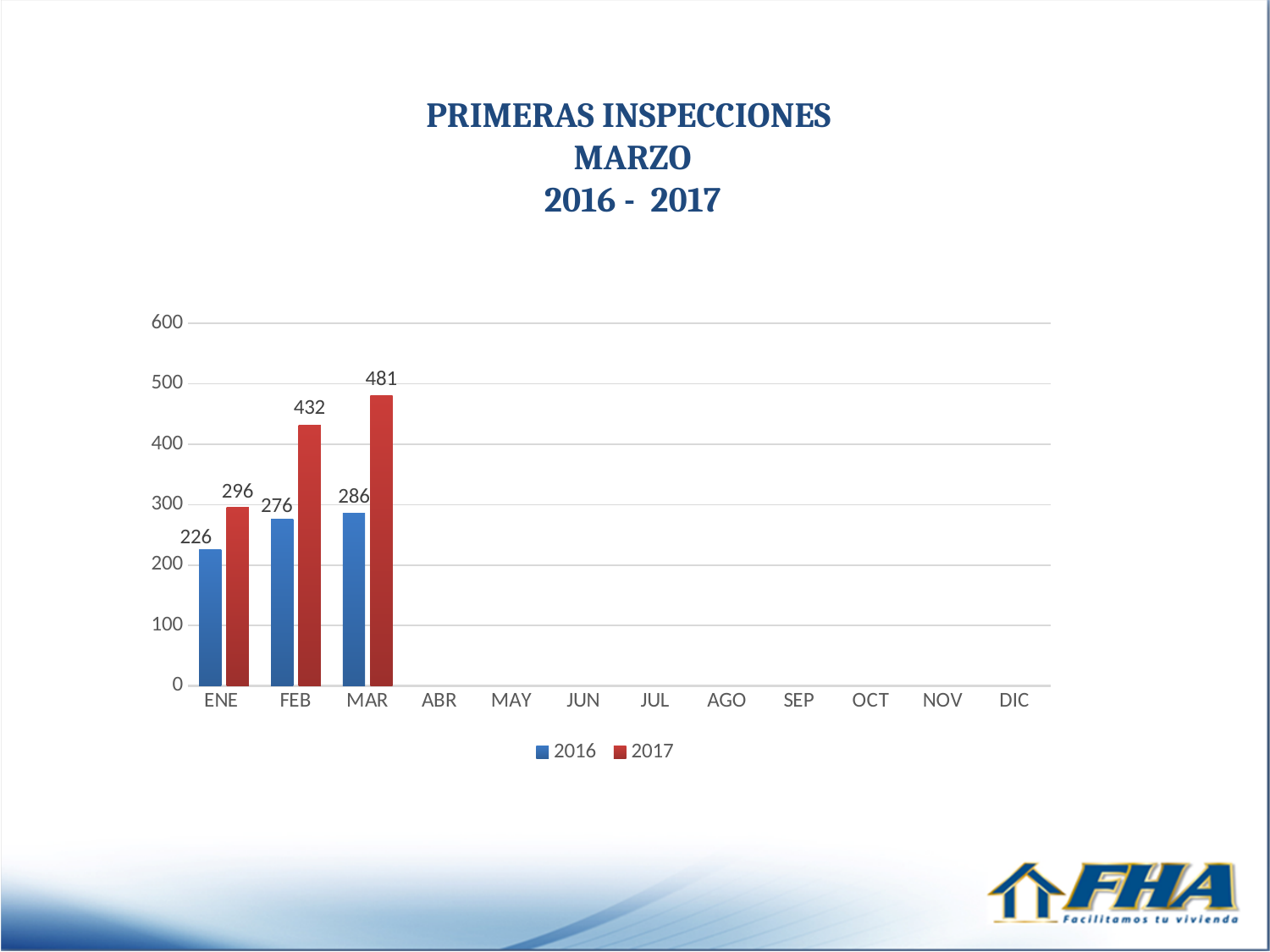
Do the 2017 values rise or fall from ENE to MAR? Rise What kind of chart is shown on the slide? Bar chart What is the difference between the 2017 and 2016 values in MAR? 195 Is the value for 2017 in FEB greater or less than 400? greater Which month has the highest value for the 2017 series? MAR What is the value for 2016 in MAR? 286 How many series does the legend list? 2 Which month has the lowest value for the 2016 series? ENE What is the value for 2017 in FEB? 432 How many month categories are shown on the x axis? 12 What is the value for 2016 in ENE? 226 Which is larger in ENE, the 2016 value or the 2017 value? 2017